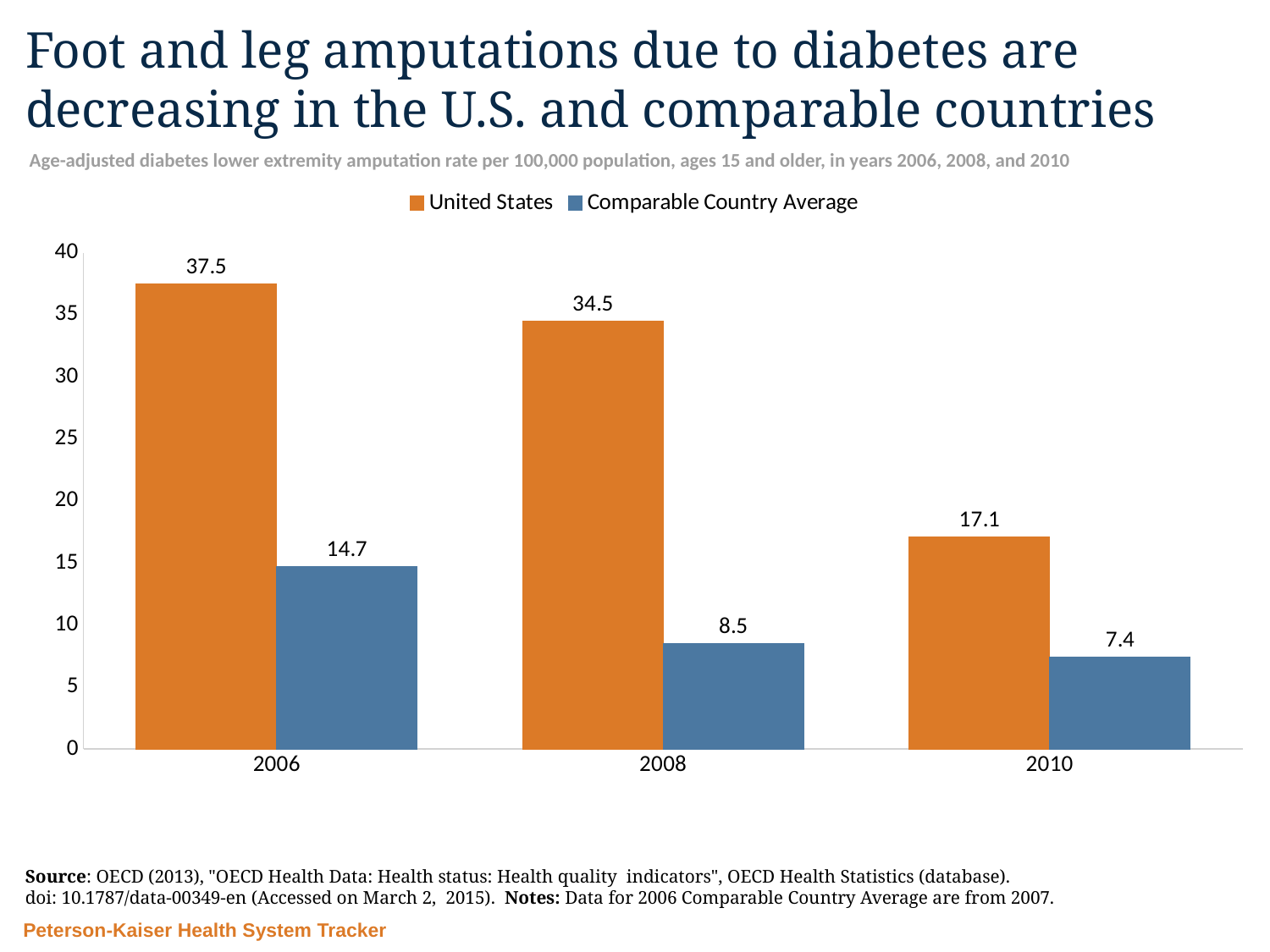
What is the United States value in 2010? 17.1 How many years are shown on the x axis? 3 What is the United States amputation rate in 2006? 37.5 In which year is the Comparable Country Average value lowest? 2010 In which year is the United States value highest? 2006 Which is larger in 2010, the United States value or the Comparable Country Average value? United States By how much did the United States value fall from 2006 to 2010? 20.4 What kind of chart is shown on the slide? Bar chart Do the United States values rise or fall from 2006 to 2010? Fall What is the Comparable Country Average value in 2008? 8.5 What is the difference between the United States and Comparable Country Average values in 2008? 26 How many series does the legend list? 2